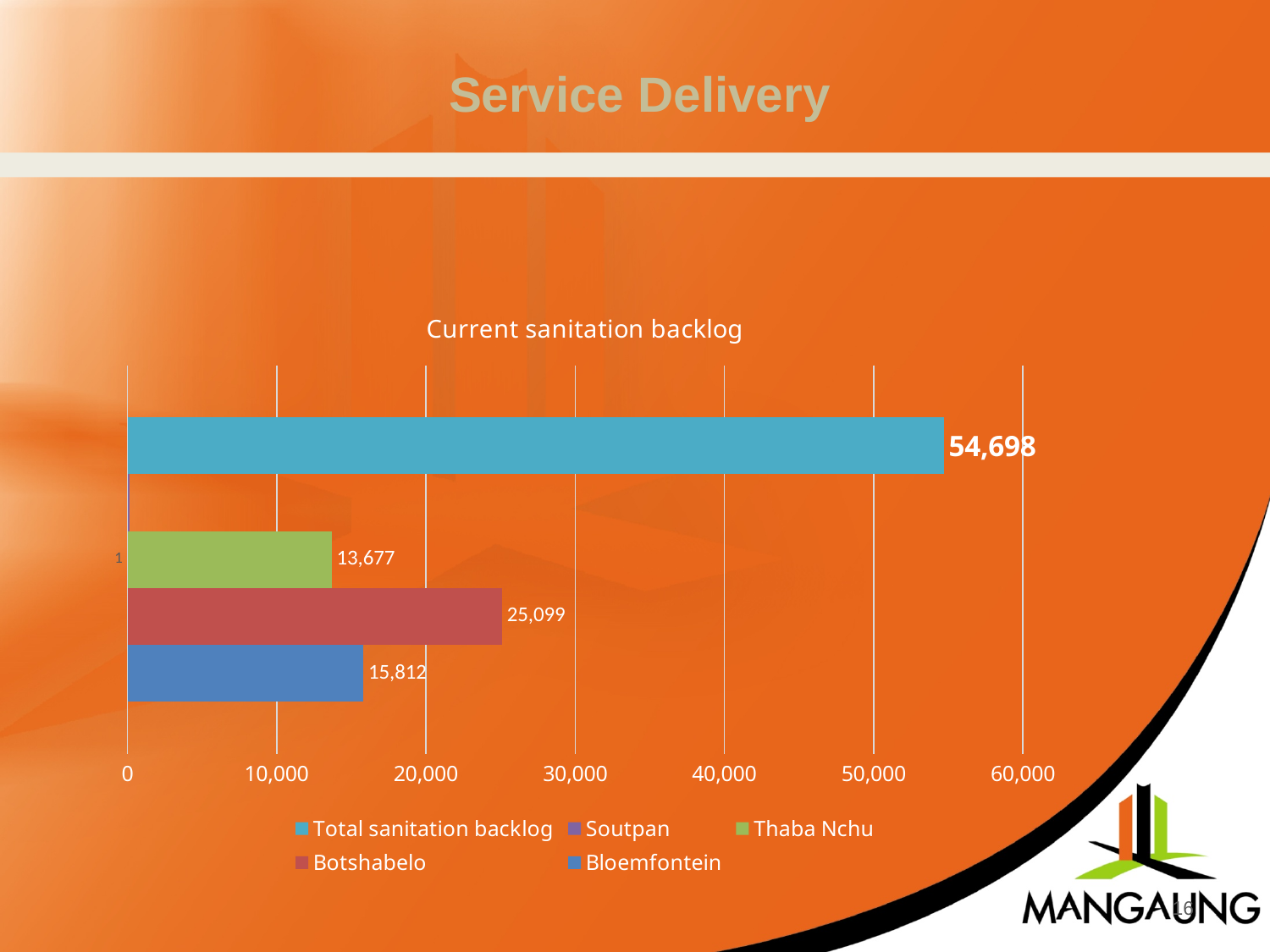
What is the difference between the Bloemfontein and Thaba Nchu values? 2,135 What is the value of the Total sanitation backlog bar? 54,698 What is the sanitation backlog value shown for Thaba Nchu? 13,677 What is the sanitation backlog value shown for Botshabelo? 25,099 What is the sanitation backlog value shown for Bloemfontein? 15,812 What is the difference between the Botshabelo and Bloemfontein values? 9,287 What kind of chart is shown on the slide? bar chart Which series has the longest bar in the chart? Total sanitation backlog Is the value for Botshabelo greater or less than 20,000? greater What is the title of the chart? Current sanitation backlog How many series does the legend list? 5 Which has a larger sanitation backlog, Botshabelo or Thaba Nchu? Botshabelo